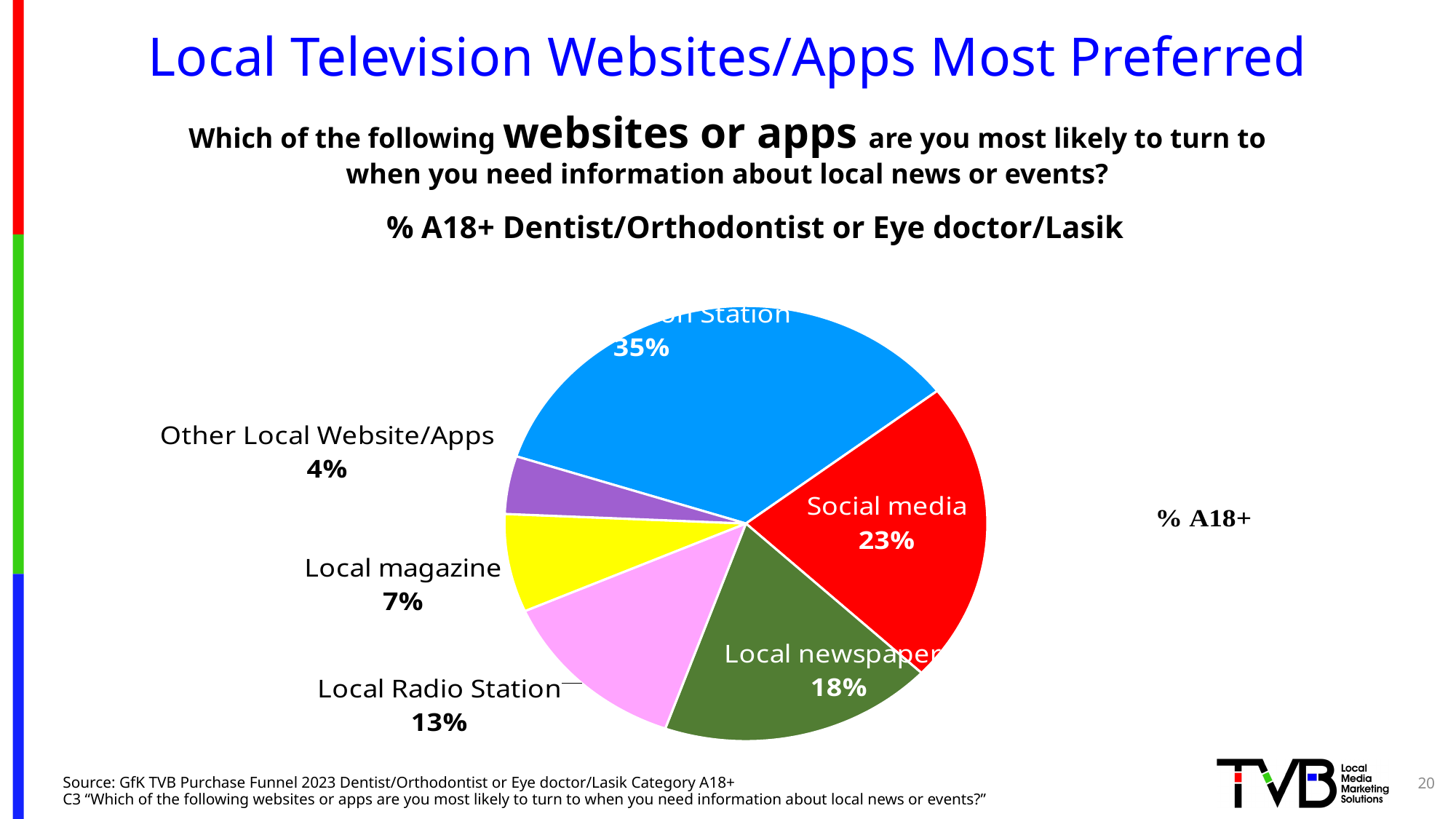
What is the percentage shown on the largest (blue) slice of the pie? 35% Which is larger, Local Radio Station or Local magazine? Local Radio Station What percentage of the pie is Local magazine? 7% How many slices does the pie chart have? 6 What percentage of the pie is Social media? 23% What percentage of the pie is Local Radio Station? 13% What percentage of the pie is Other Local Website/Apps? 4% What colour is the Social media slice? red What type of chart is shown on the slide? pie chart What is the difference in percentage points between Social media and Local newspaper? 5 What percentage of the pie is Local newspaper? 18% Which category has the smallest share of the pie? Other Local Website/Apps